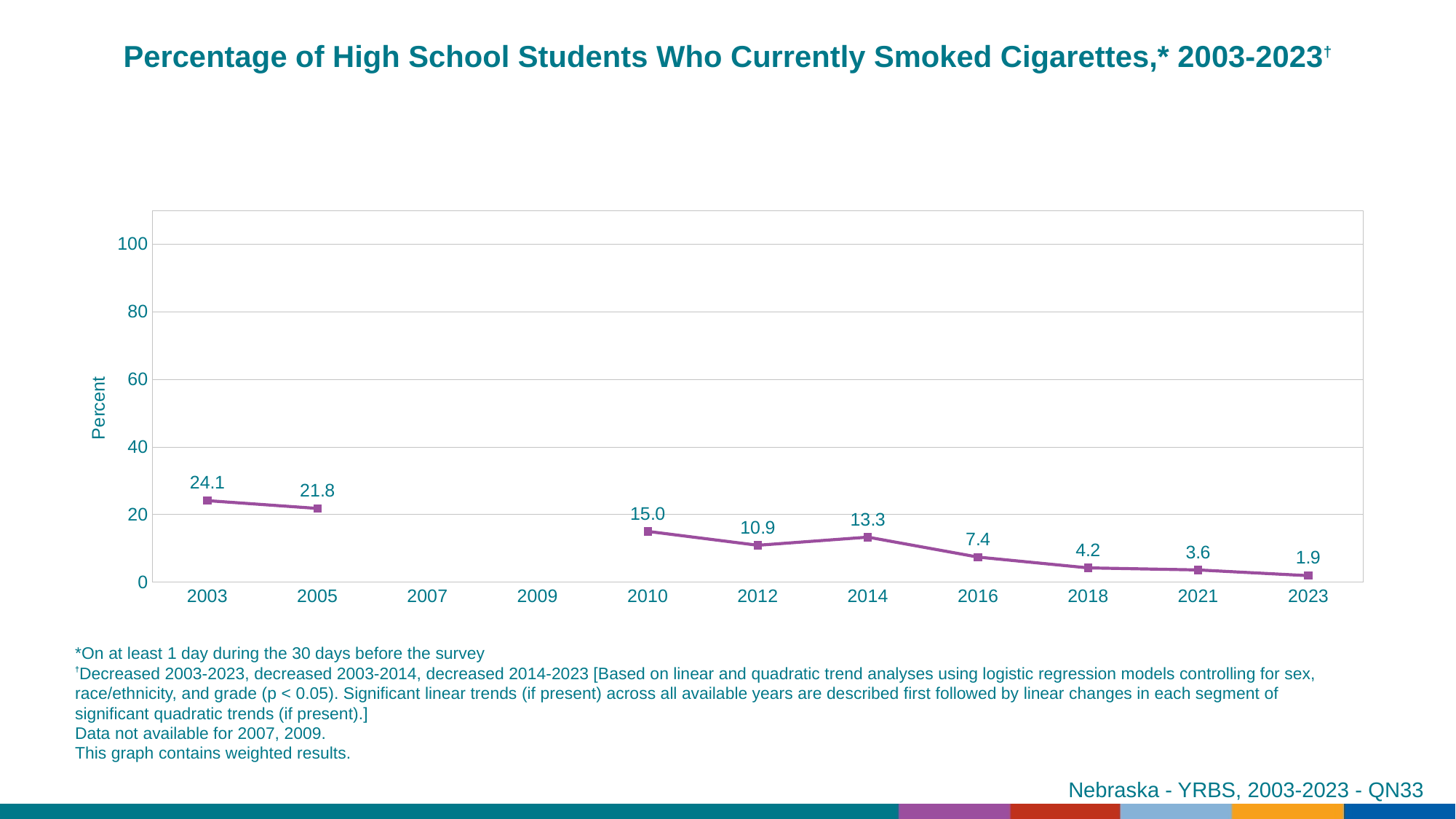
What percentage of high school students currently smoked cigarettes in 2003? 24.1 What kind of chart is shown on the slide? line chart What is the difference between the values for 2003 and 2005? 2.3 Which year has the highest percentage of students who currently smoked cigarettes? 2003 Which year has a larger value, 2012 or 2014? 2014 Do the values generally rise or fall from 2003 to 2023? fall How many years have data points plotted on the chart? 9 What is the value plotted for 2023? 1.9 Which year has the lowest percentage of students who currently smoked cigarettes? 2023 What is the value plotted for 2014? 13.3 What is the difference between the values for 2010 and 2012? 4.1 Is the value for 2016 greater or less than 20? less